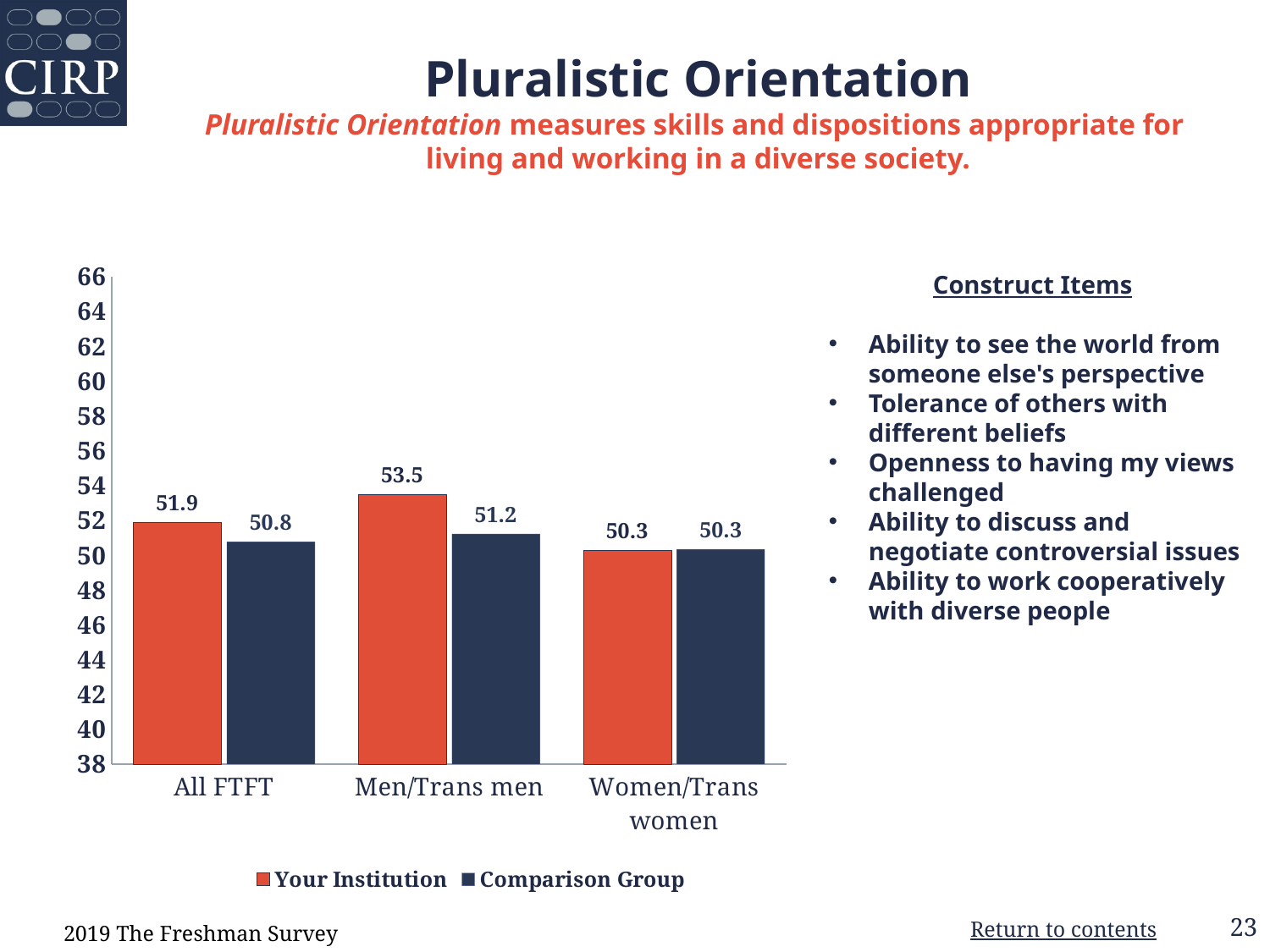
Which category has the highest Your Institution value? Men/Trans men What is the Your Institution value for Women/Trans women? 50.3 How many series does the legend list? 2 What is the difference between the Your Institution and Comparison Group values for Men/Trans men? 2.3 What is the Your Institution value for All FTFT? 51.9 What is the difference between the Your Institution and Comparison Group values for All FTFT? 1.1 Which is larger for All FTFT: Your Institution or Comparison Group? Your Institution Which category has the lowest Comparison Group value? Women/Trans women What kind of chart is shown on the slide? bar chart How many categories are shown on the x axis? 3 What is the Comparison Group value for Men/Trans men? 51.2 Is the Your Institution value for Men/Trans men greater or less than 52? greater